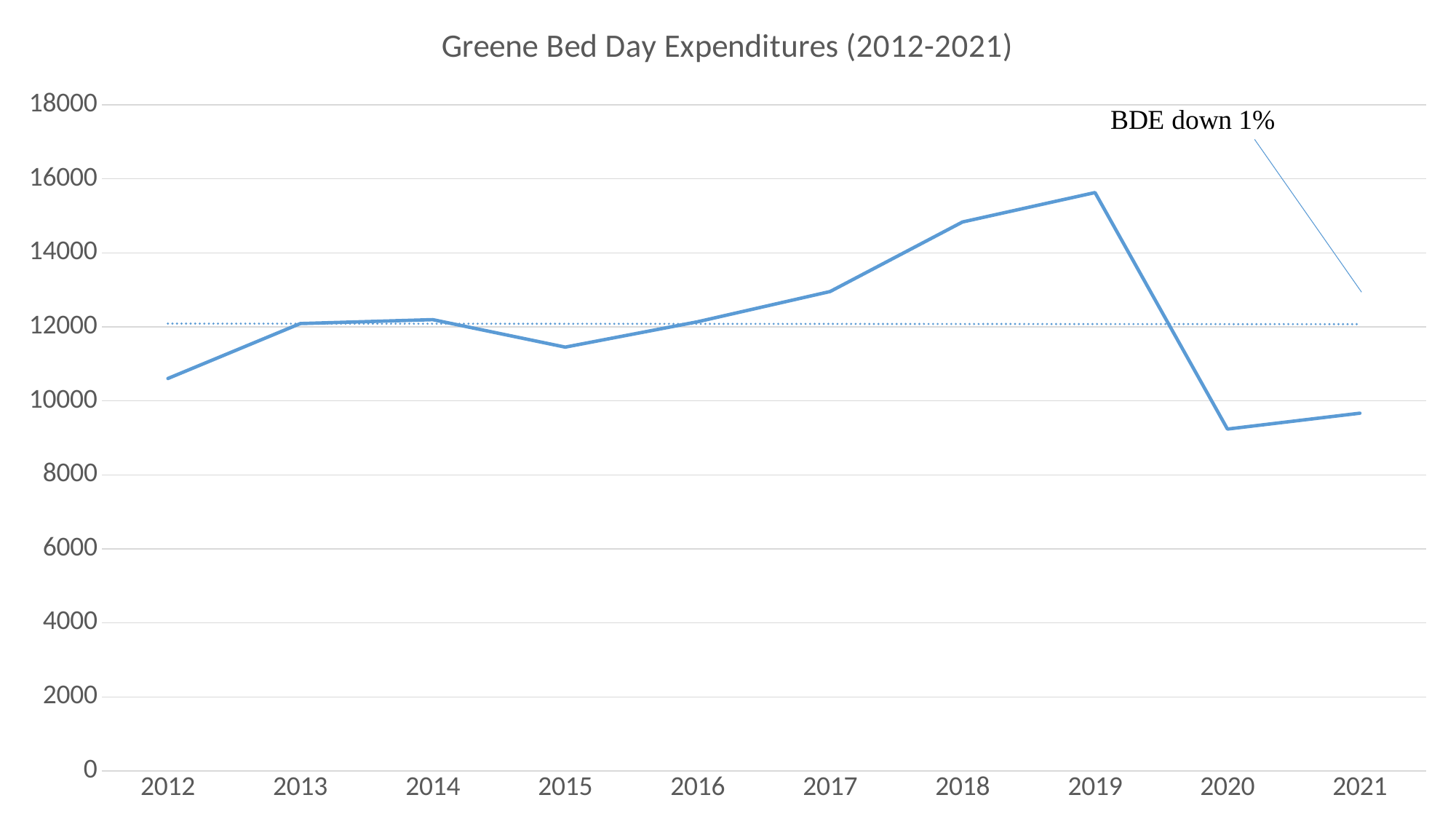
What kind of chart is shown on the slide? line chart What is the title of the chart? Greene Bed Day Expenditures (2012-2021) Is the value for 2019 greater or less than 14000? greater How many years are plotted on the x axis? 10 Is the value for 2012 greater or less than 10000? greater What does the text annotation on the chart say? BDE down 1% Which year has the lowest bed day expenditure? 2020 Is the value for 2020 greater or less than 10000? less Which year has the larger value, 2018 or 2020? 2018 Do the values rise or fall from 2015 to 2019? rise Which year has the highest bed day expenditure? 2019